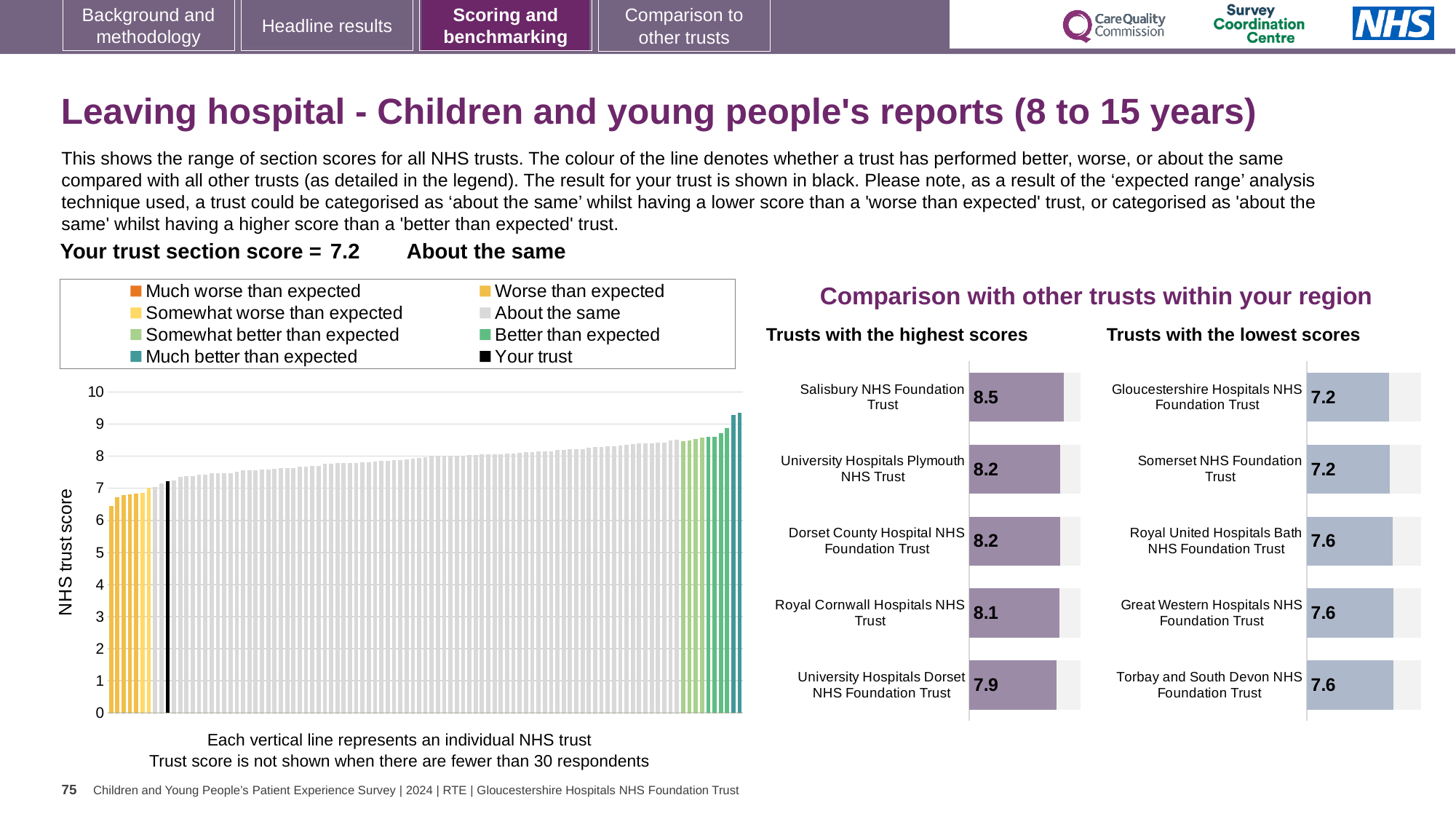
In the 'Trusts with the lowest scores' chart, what is the difference between the scores of Torbay and South Devon NHS Foundation Trust and Gloucestershire Hospitals NHS Foundation Trust? 0.4 In the large chart on the left, is the value of the tallest bar greater or less than 9? greater In the 'Trusts with the lowest scores' chart, what is the score for Somerset NHS Foundation Trust? 7.2 How many entries does the legend above the large chart on the left list? 8 How many trusts are shown in the 'Trusts with the lowest scores' chart? 5 In the large chart on the left, do the bar values rise or fall from left to right? rise In the 'Trusts with the lowest scores' chart, which has the larger score: Gloucestershire Hospitals NHS Foundation Trust or Royal United Hospitals Bath NHS Foundation Trust? Royal United Hospitals Bath NHS Foundation Trust In the 'Trusts with the highest scores' chart, which trust has the lowest score? University Hospitals Dorset NHS Foundation Trust In the 'Trusts with the highest scores' chart, what is the score for Salisbury NHS Foundation Trust? 8.5 In the 'Trusts with the highest scores' chart, what is the difference between the scores of Salisbury NHS Foundation Trust and University Hospitals Dorset NHS Foundation Trust? 0.6 In the 'Trusts with the highest scores' chart, which trust has the highest score? Salisbury NHS Foundation Trust What kind of chart is the large chart on the left? bar chart